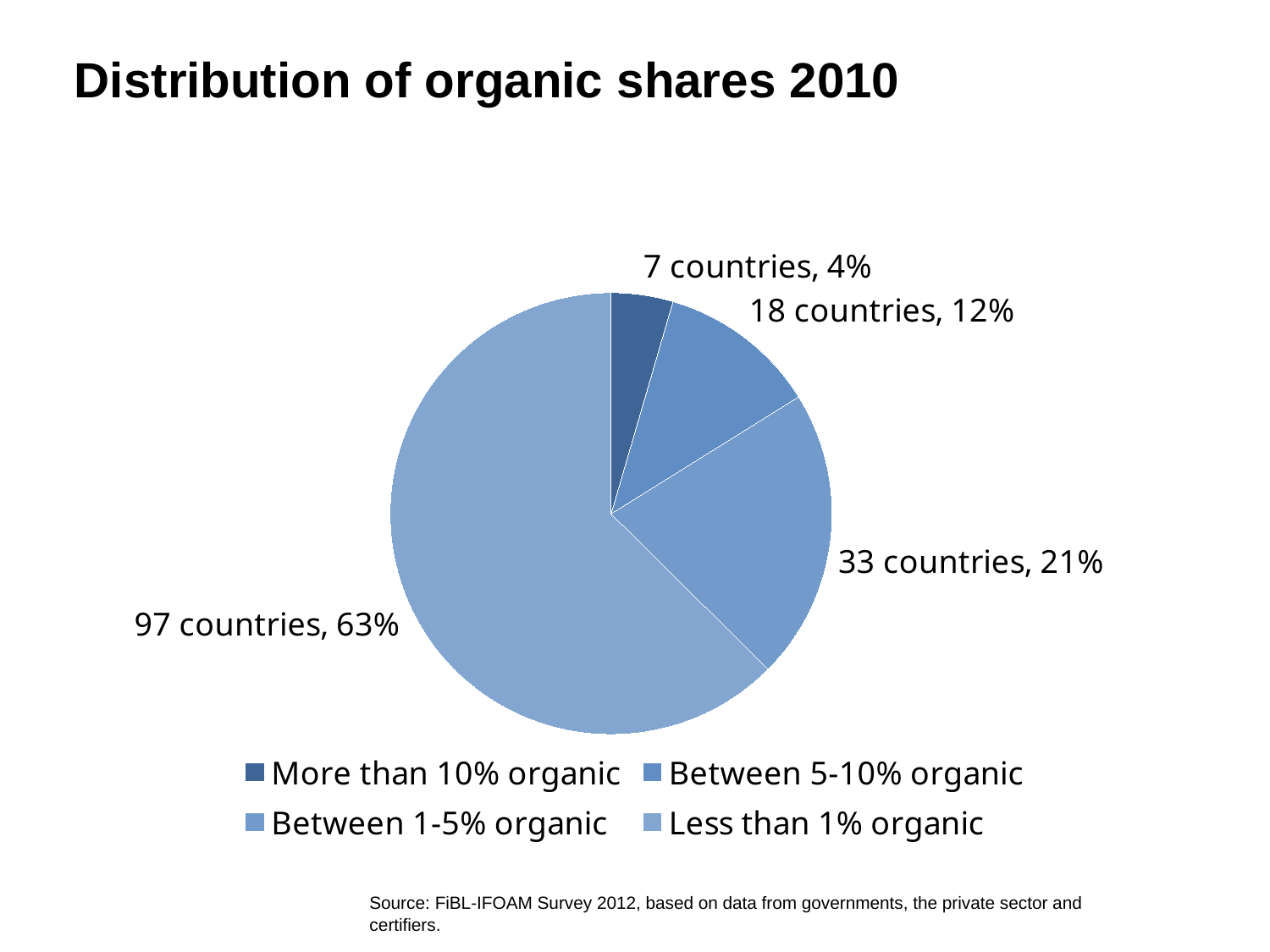
How many more countries are in the 'Less than 1% organic' category than in the 'Between 1-5% organic' category? 64 What kind of chart is shown on the slide? Pie chart How many categories does the pie chart have? 4 What percentage of the pie does the 'Less than 1% organic' slice represent? 63% What is the title of the chart? Distribution of organic shares 2010 Which has more countries: 'Between 5-10% organic' or 'Between 1-5% organic'? Between 1-5% organic How many countries have more than 10% organic share? 7 countries Which category has the smallest slice of the pie? More than 10% organic Which category has the largest slice of the pie? Less than 1% organic What is the total number of countries represented in the pie chart? 155 What share of the pie is the 'Between 5-10% organic' slice? 12% How many countries fall in the 'Between 1-5% organic' category? 33 countries